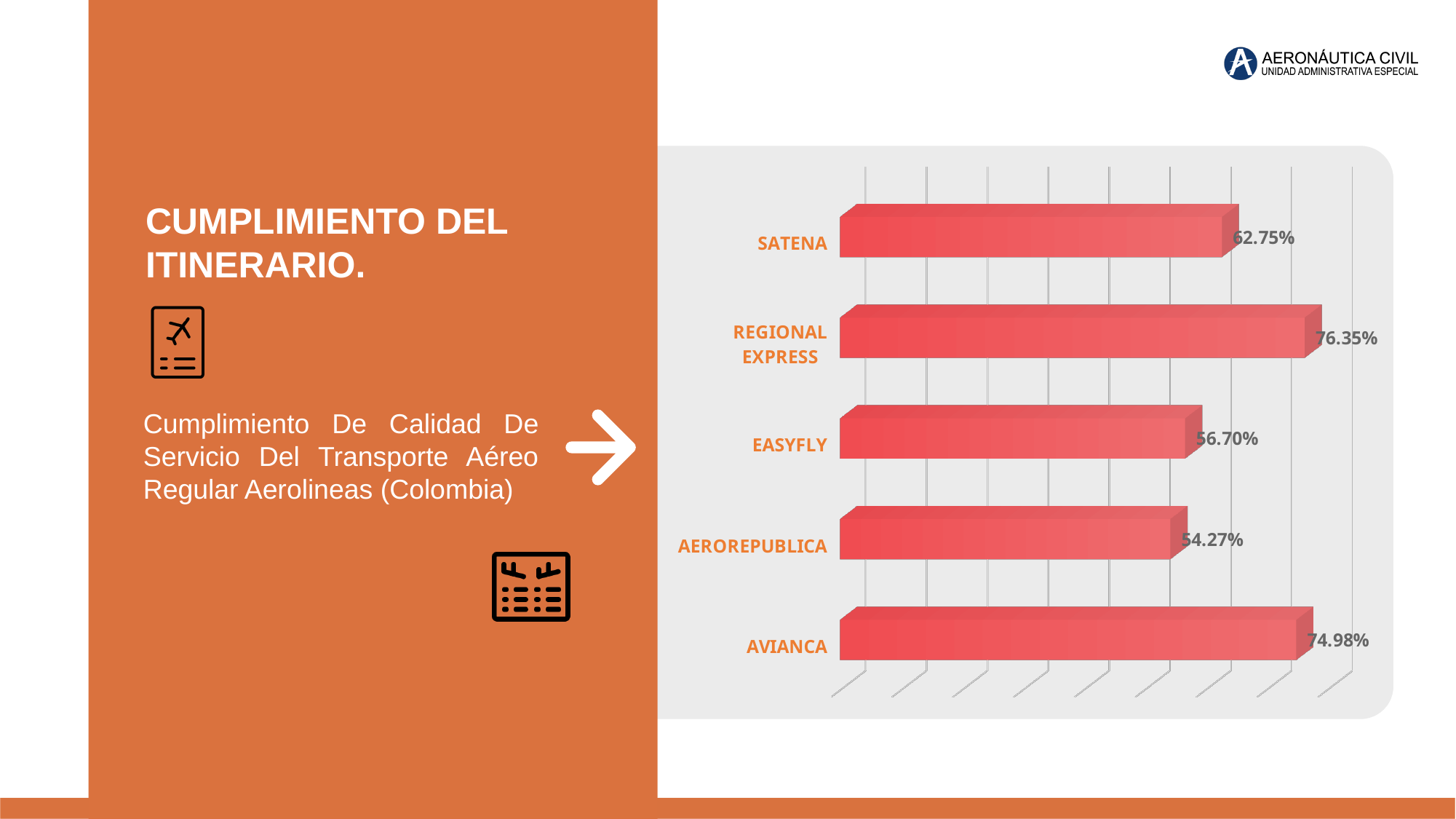
How many airlines are shown in the chart? 5 What is the value for EASYFLY? 56.70% Which airline has the highest value? REGIONAL EXPRESS What is the value for AVIANCA? 74.98% What is the difference between the values for REGIONAL EXPRESS and AVIANCA? 1.37% Which is larger, the value for SATENA or the value for EASYFLY? SATENA What is the value for SATENA? 62.75% What kind of chart is shown on the slide? Bar chart What is the value for AEROREPUBLICA? 54.27% What is the difference between the values for SATENA and EASYFLY? 6.05% What is the value for REGIONAL EXPRESS? 76.35% Which airline has the lowest value? AEROREPUBLICA